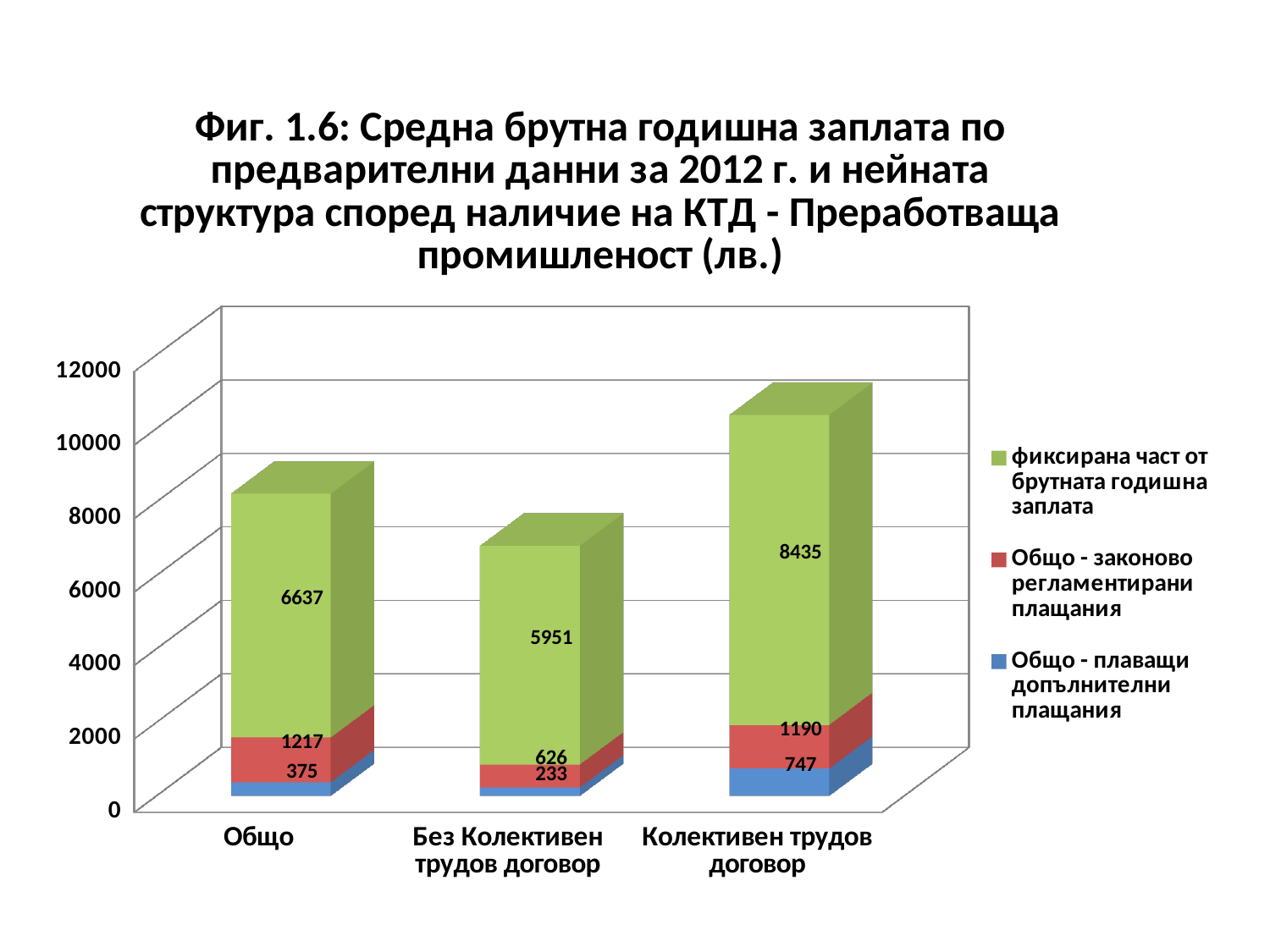
What is the value of Общо - плаващи допълнителни плащания for Без Колективен трудов договор? 233 What is the value of the fixed part of gross annual salary (фиксирана част от брутната годишна заплата) for Колективен трудов договор? 8435 Which category has the highest value for фиксирана част от брутната годишна заплата? Колективен трудов договор What kind of chart is shown on the slide? Stacked bar chart What is the value of Общо - законово регламентирани плащания for the Общо category? 1217 What is the total of the stacked bar for Колективен трудов договор? 10372 Which category has the lowest value for Общо - плаващи допълнителни плащания? Без Колективен трудов договор How many categories are shown on the x axis? 3 What is the total of the stacked bar for Без Колективен трудов договор? 6810 Which is larger: Общо - законово регламентирани плащания for Общо or for Колективен трудов договор? Общо How many series does the legend list? 3 What is the difference between the fixed part of gross annual salary for Колективен трудов договор and for Без Колективен трудов договор? 2484